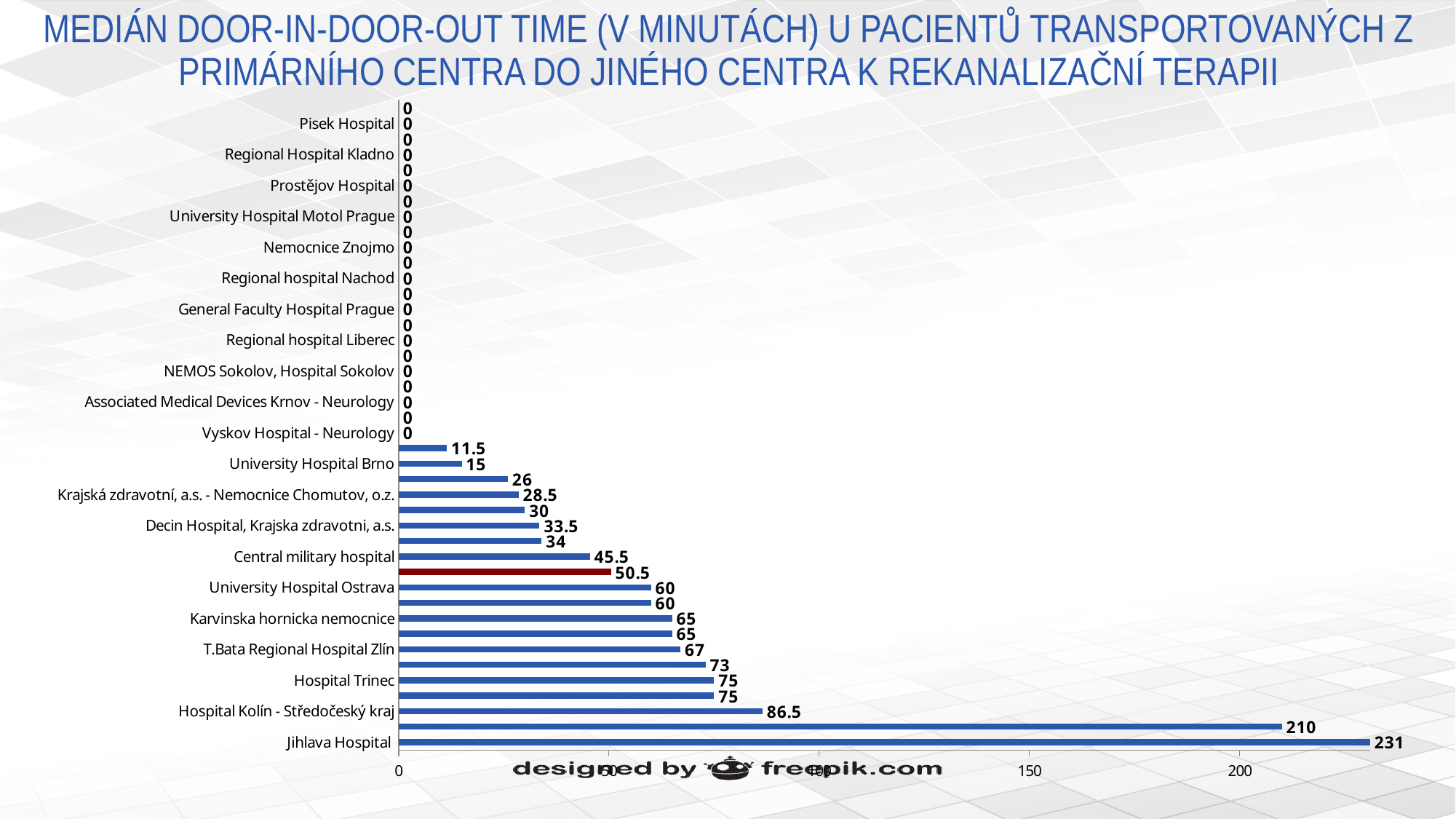
What is the value shown for Hospital Kolín - Středočeský kraj? 86.5 What is the value shown for T.Bata Regional Hospital Zlín? 67 What is the value shown for Central military hospital? 45.5 Which labeled hospital has the highest median door-in-door-out time? Jihlava Hospital What value is labeled on the single red bar in the chart? 50.5 Is the value for Hospital Trinec greater or less than 50? greater What type of chart is shown on the slide? bar chart What is the median door-in-door-out time for Jihlava Hospital? 231 What is the difference between the values for Jihlava Hospital and Hospital Kolín - Středočeský kraj? 144.5 What is the value shown for Pisek Hospital? 0 Which has a larger value, Karvinska hornicka nemocnice or University Hospital Brno? Karvinska hornicka nemocnice What is the value shown for University Hospital Brno? 15